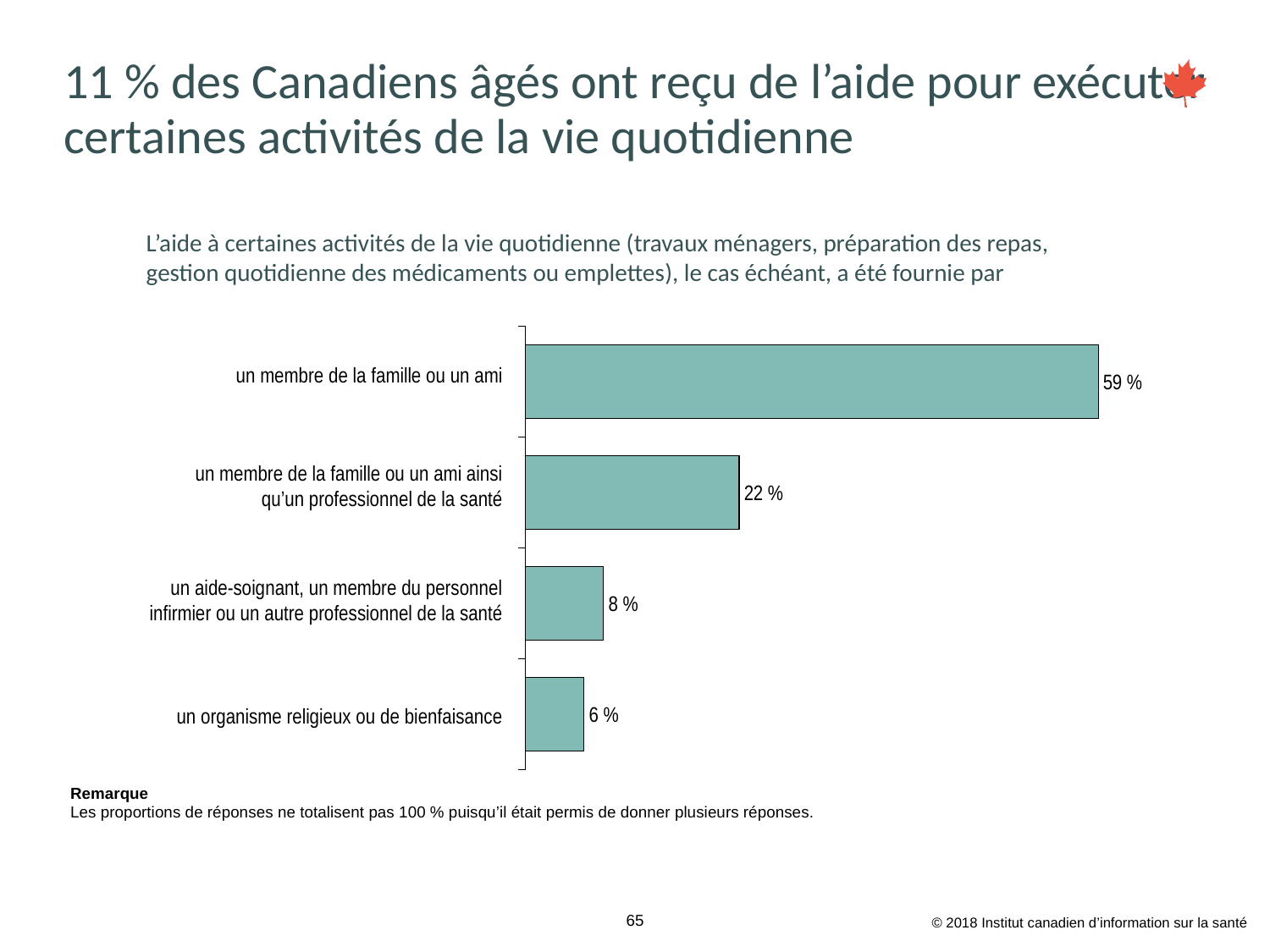
What value is shown for "un membre de la famille ou un ami ainsi qu'un professionnel de la santé"? 22 % What value is shown for "un aide-soignant, un membre du personnel infirmier ou un autre professionnel de la santé"? 8 % What kind of chart is shown on the slide? bar chart Which category has the lowest value? un organisme religieux ou de bienfaisance What value is shown for "un organisme religieux ou de bienfaisance"? 6 % Which is larger: the value for "un membre de la famille ou un ami ainsi qu'un professionnel de la santé" or the value for "un aide-soignant, un membre du personnel infirmier ou un autre professionnel de la santé"? un membre de la famille ou un ami ainsi qu'un professionnel de la santé What value is shown for "un membre de la famille ou un ami"? 59 % Which category has the highest value? un membre de la famille ou un ami What is the difference between the values for "un membre de la famille ou un ami" and "un membre de la famille ou un ami ainsi qu'un professionnel de la santé"? 37 % What is the difference between the values for "un aide-soignant, un membre du personnel infirmier ou un autre professionnel de la santé" and "un organisme religieux ou de bienfaisance"? 2 % How many categories are shown in the chart? 4 According to the note below the chart, why do the proportions not total 100 %? Il était permis de donner plusieurs réponses